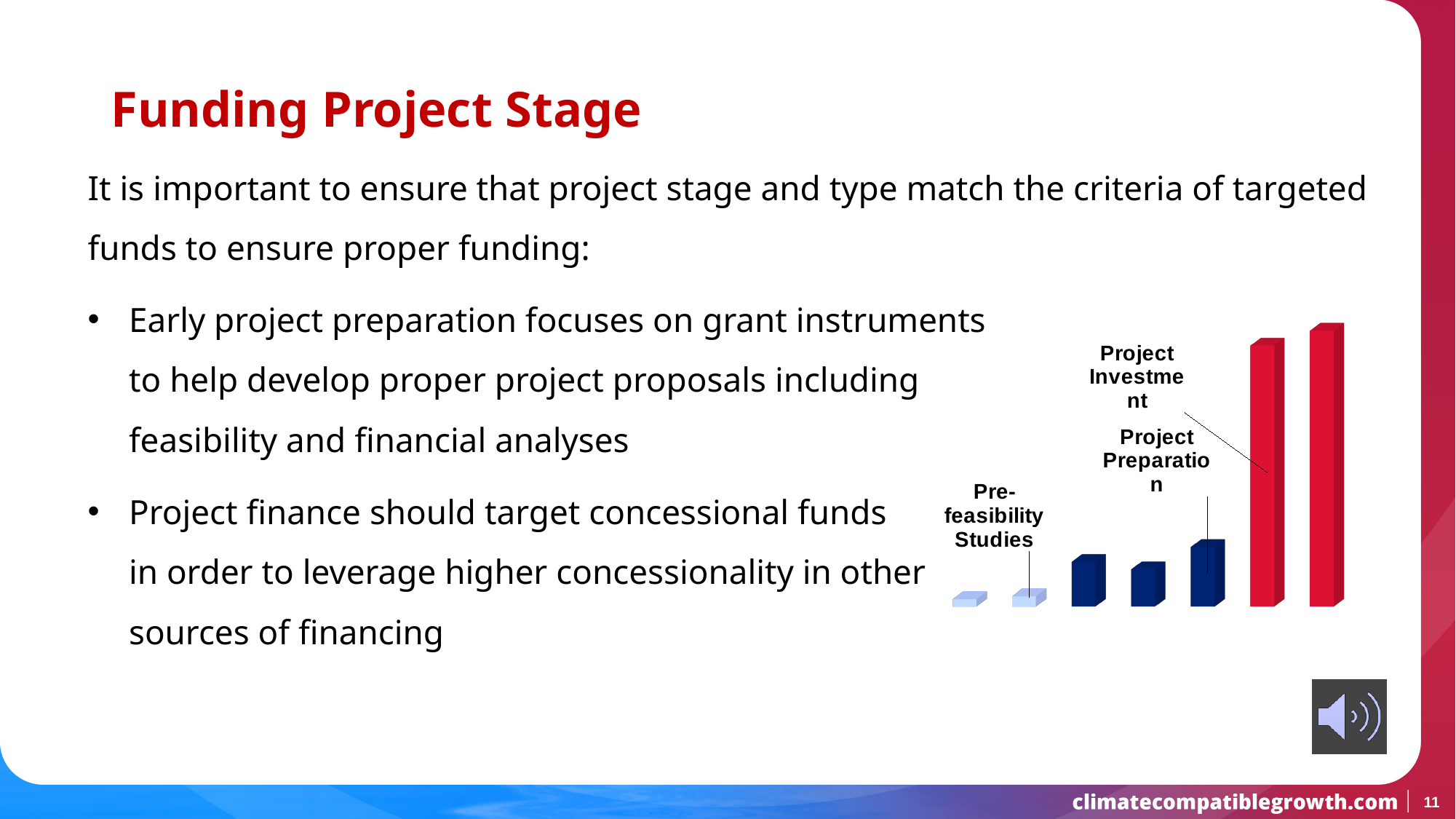
Are the bars for Project Investment taller or shorter than the bars for Project Preparation? Taller Do the bar heights generally rise or fall from left to right across the chart? Rise How many bars are plotted in the chart? 7 What colour are the bars for the Project Preparation stage? Dark blue Which labelled project stage has the shortest bars in the chart? Pre-feasibility Studies Are the bars for Project Preparation taller or shorter than the bars for Pre-feasibility Studies? Taller How many project stages are labelled in the chart? 3 How many bars belong to the Project Preparation stage? 3 Which labelled project stage has the tallest bars in the chart? Project Investment What colour are the bars for the Project Investment stage? Red What kind of chart is shown on the slide? Bar chart